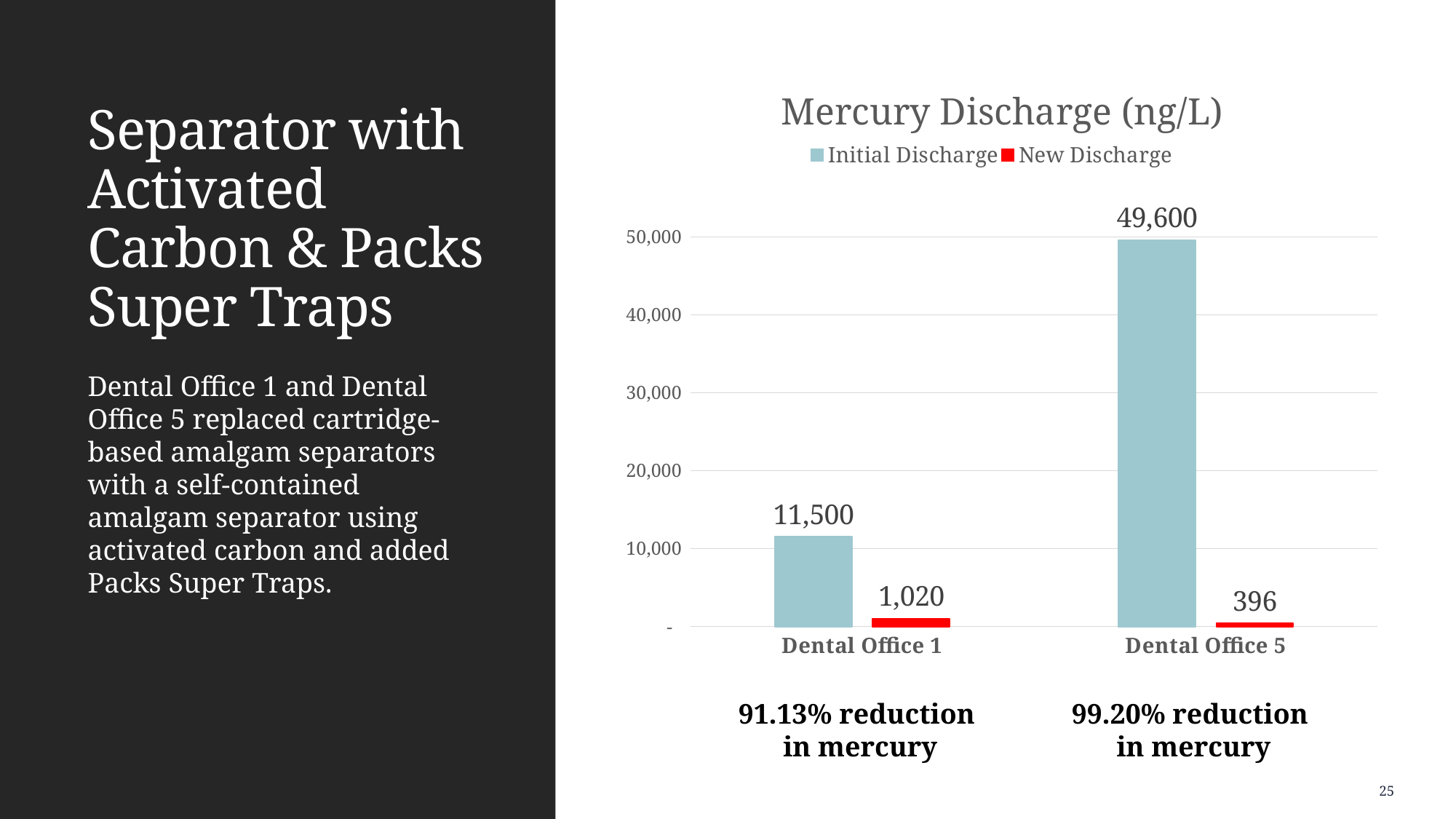
Which dental office has the lowest New Discharge? Dental Office 5 What is the difference between the Initial Discharge values of Dental Office 5 and Dental Office 1? 38,100 What is the New Discharge value for Dental Office 1? 1,020 What is the Initial Discharge value for Dental Office 1? 11,500 What is the Initial Discharge value for Dental Office 5? 49,600 Which dental office has the highest Initial Discharge? Dental Office 5 How many dental offices are shown on the x axis? 2 Which is larger, the New Discharge for Dental Office 1 or the New Discharge for Dental Office 5? Dental Office 1 What is the difference between the Initial Discharge and New Discharge for Dental Office 1? 10,480 How many series does the legend list? 2 What is the title of the chart? Mercury Discharge (ng/L) What is the New Discharge value for Dental Office 5? 396